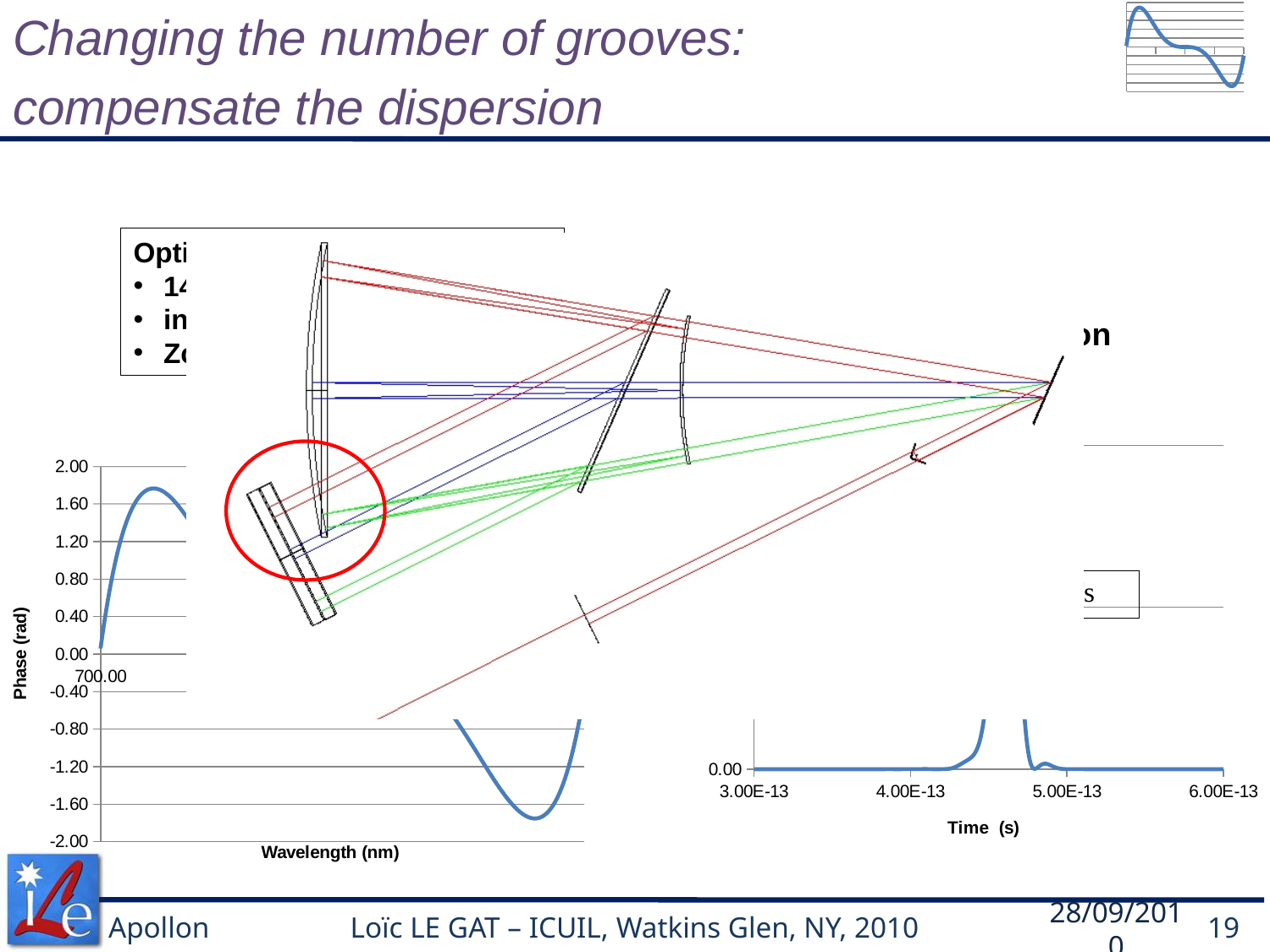
On the left chart, does the phase curve rise or fall immediately after 700.00 nm? rise On the left chart, is the phase value at 700.00 nm greater or less than 0.40? less On the left chart, is the highest value of the phase curve greater or less than 1.20? greater On the right chart (Time axis), what kind of chart is it? line chart On the right chart, what is the label of the horizontal axis? Time (s) On the left chart, what is the label of the vertical axis? Phase (rad) On the right chart, what is the last tick value shown on the Time axis? 6.00E-13 On the left chart (Phase vs Wavelength), what kind of chart is it? line chart On the left chart, is the lowest value of the phase curve greater or less than -1.20? less On the left chart, what is the highest tick value shown on the vertical axis? 2.00 On the right chart, how many tick labels are shown on the Time axis? 4 On the left chart, what is the lowest tick value shown on the vertical axis? -2.00